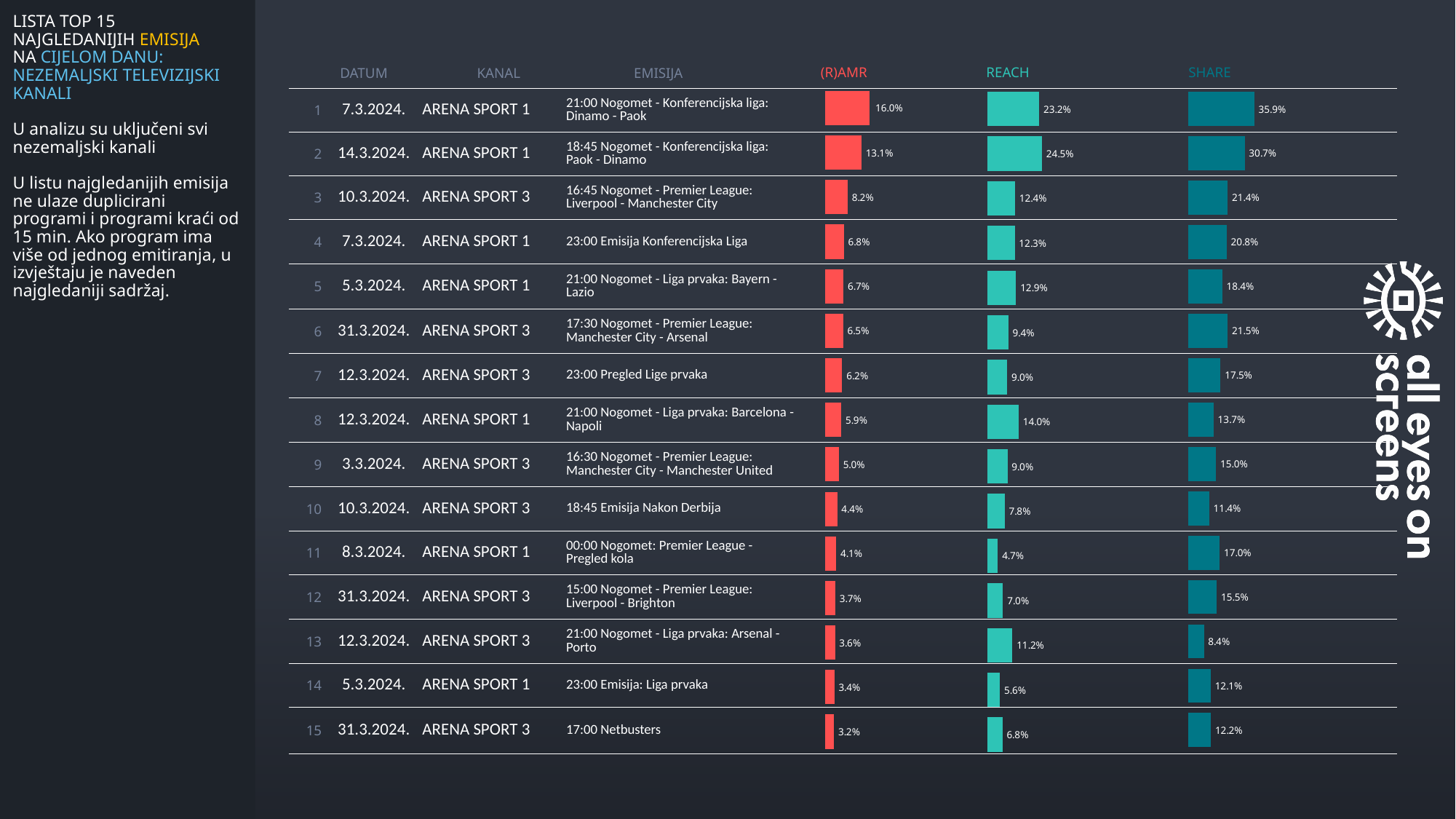
How many programmes are listed in the table? 15 What is the difference in (R)AMR between the programme ranked 1 and the programme ranked 2? 2.9% Which has a higher SHARE value: 23:00 Pregled Lige prvaka or 21:00 Nogomet - Liga prvaka: Barcelona - Napoli? 23:00 Pregled Lige prvaka What kind of chart is used to display the (R)AMR, REACH and SHARE values? Bar chart What is the REACH value for 17:00 Netbusters? 6.8% What is the REACH value for the programme ranked 2, 18:45 Nogomet - Konferencijska liga: Paok - Dinamo? 24.5% Do the (R)AMR values rise or fall going down the list from rank 1 to rank 15? Fall Which programme has the highest REACH value? 18:45 Nogomet - Konferencijska liga: Paok - Dinamo What is the (R)AMR value for the programme ranked 1, 21:00 Nogomet - Konferencijska liga: Dinamo - Paok? 16.0% What is the SHARE value for the programme ranked 3, 16:45 Nogomet - Premier League: Liverpool - Manchester City? 21.4% Which programme has the lowest SHARE value? 21:00 Nogomet - Liga prvaka: Arsenal - Porto What colour are the bars in the (R)AMR column? Red